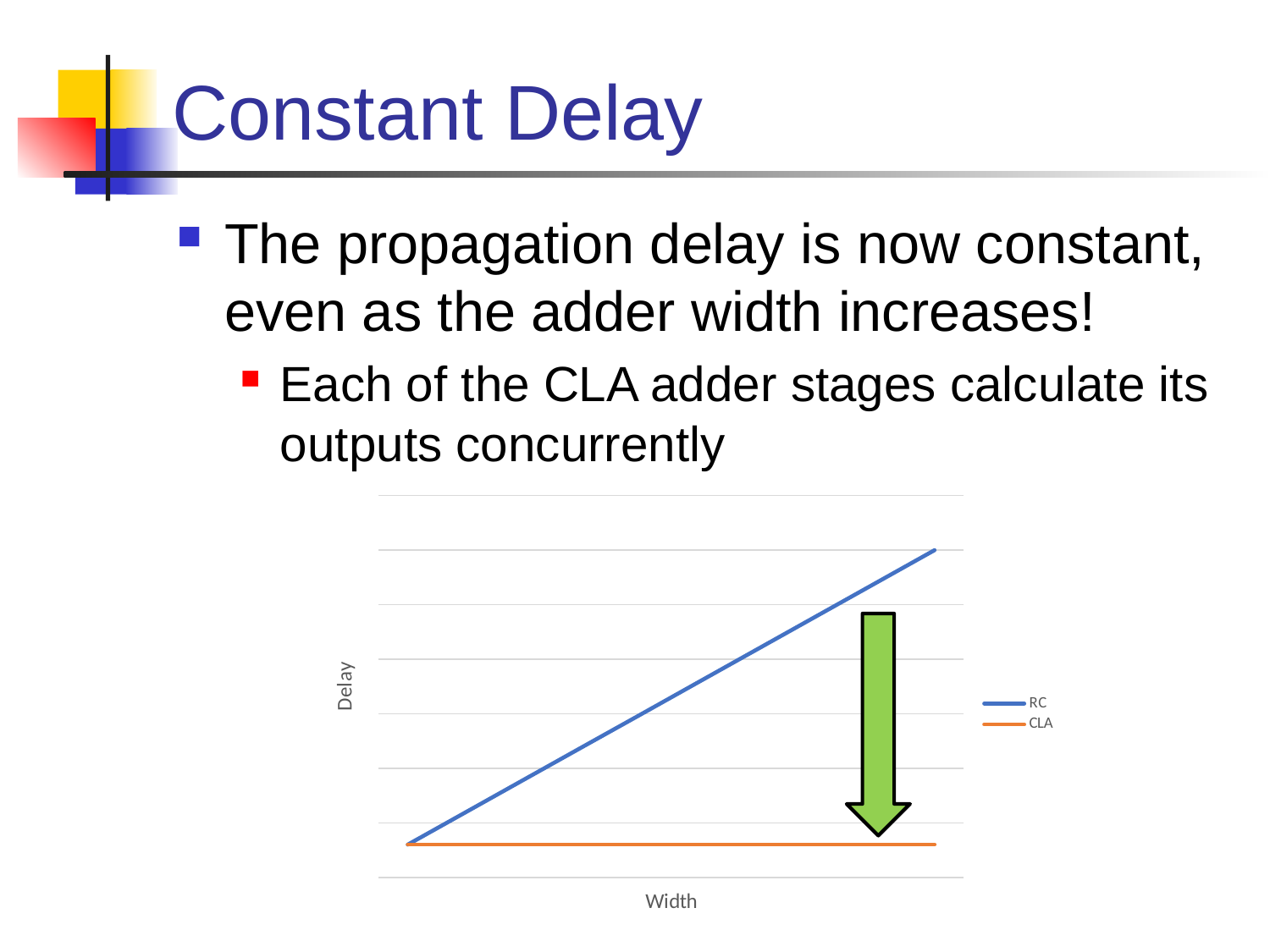
How many series does the chart's legend list? 2 What kind of chart is shown on the slide? line chart What is the label on the chart's vertical axis? Delay Which series shows the lower Delay across the chart? CLA Does the CLA line rise, fall, or stay flat as Width increases? stays flat At the right end of the chart, which series has the higher Delay, RC or CLA? RC Does the RC line rise or fall as Width increases? rises What is the label on the chart's horizontal axis? Width Which two series are listed in the chart's legend? RC and CLA